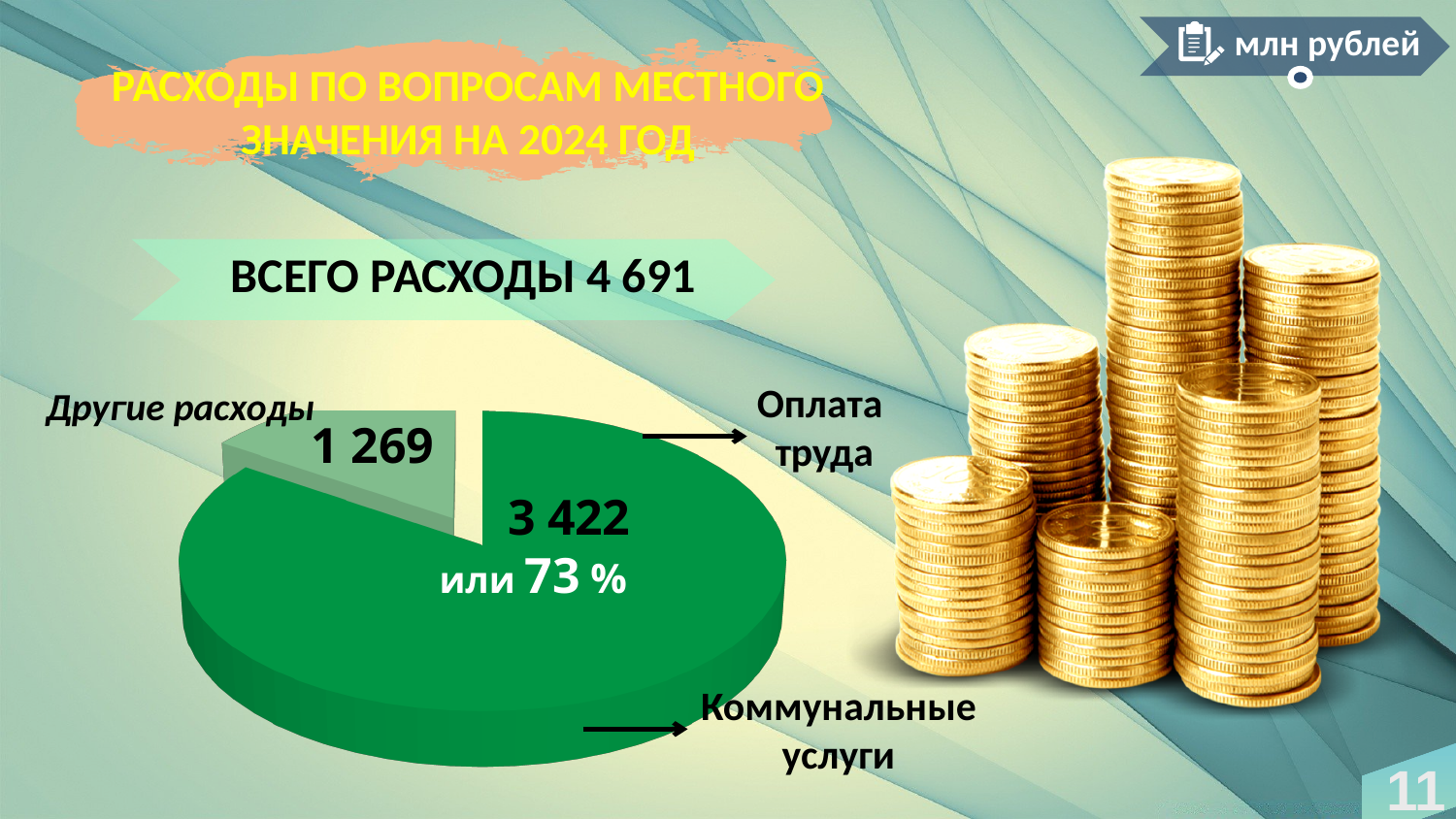
What is the difference between the green slice (3 422) and the 'Другие расходы' slice (1 269)? 2 153 What total expenditure figure is printed above the pie chart ('ВСЕГО РАСХОДЫ')? 4 691 What is the value printed on the large green slice of the pie chart? 3 422 What unit of measurement is indicated in the top-right corner of the slide? млн рублей What kind of chart is shown on the slide? pie chart What is the title of the slide containing the pie chart? РАСХОДЫ ПО ВОПРОСАМ МЕСТНОГО ЗНАЧЕНИЯ НА 2024 ГОД Which slice of the pie chart is the smallest? Другие расходы Which slice of the pie chart is larger: 'Другие расходы' or the green slice labelled 3 422? the green slice labelled 3 422 How many slices does the pie chart have? 2 What percentage share is printed on the large green slice of the pie chart? 73 % What is the value of the 'Другие расходы' slice of the pie chart? 1 269